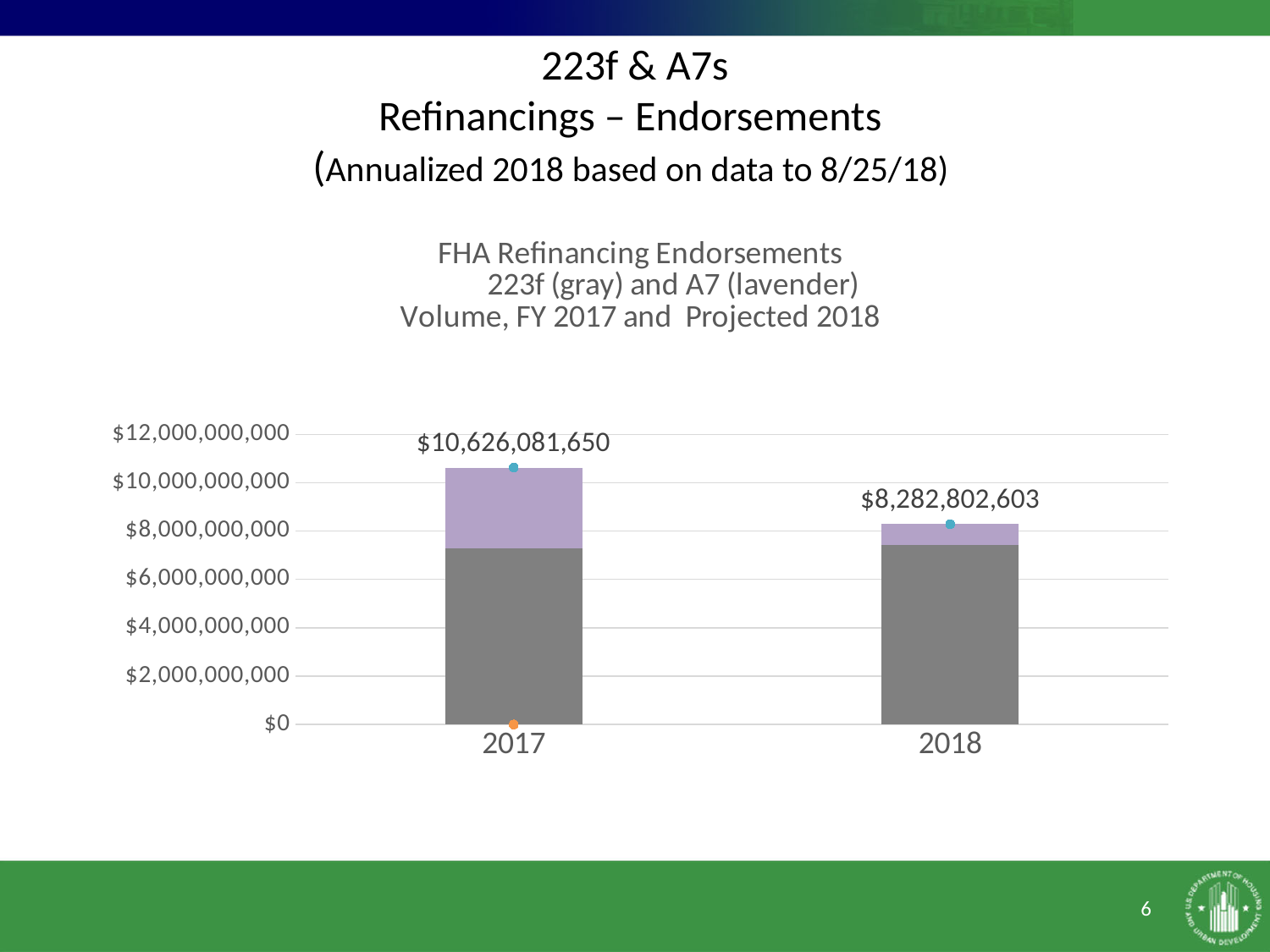
What is the difference between the 2017 total and the 2018 total? $2,343,279,047 What is the total value labeled for 2017? $10,626,081,650 Do the total values rise or fall from 2017 to 2018? Fall According to the chart title, which colour represents the 223f program? Gray What kind of chart is shown on the slide? Stacked bar chart Is the gray (223f) segment for 2017 greater or less than $6,000,000,000? greater Is the total for 2017 larger or smaller than the total for 2018? larger Which year has the lower total refinancing endorsement volume? 2018 Is the lavender (A7) segment for 2018 greater or less than $2,000,000,000? less How many years are shown on the x axis? 2 Which year has the higher total refinancing endorsement volume? 2017 What is the total value labeled for 2018? $8,282,802,603